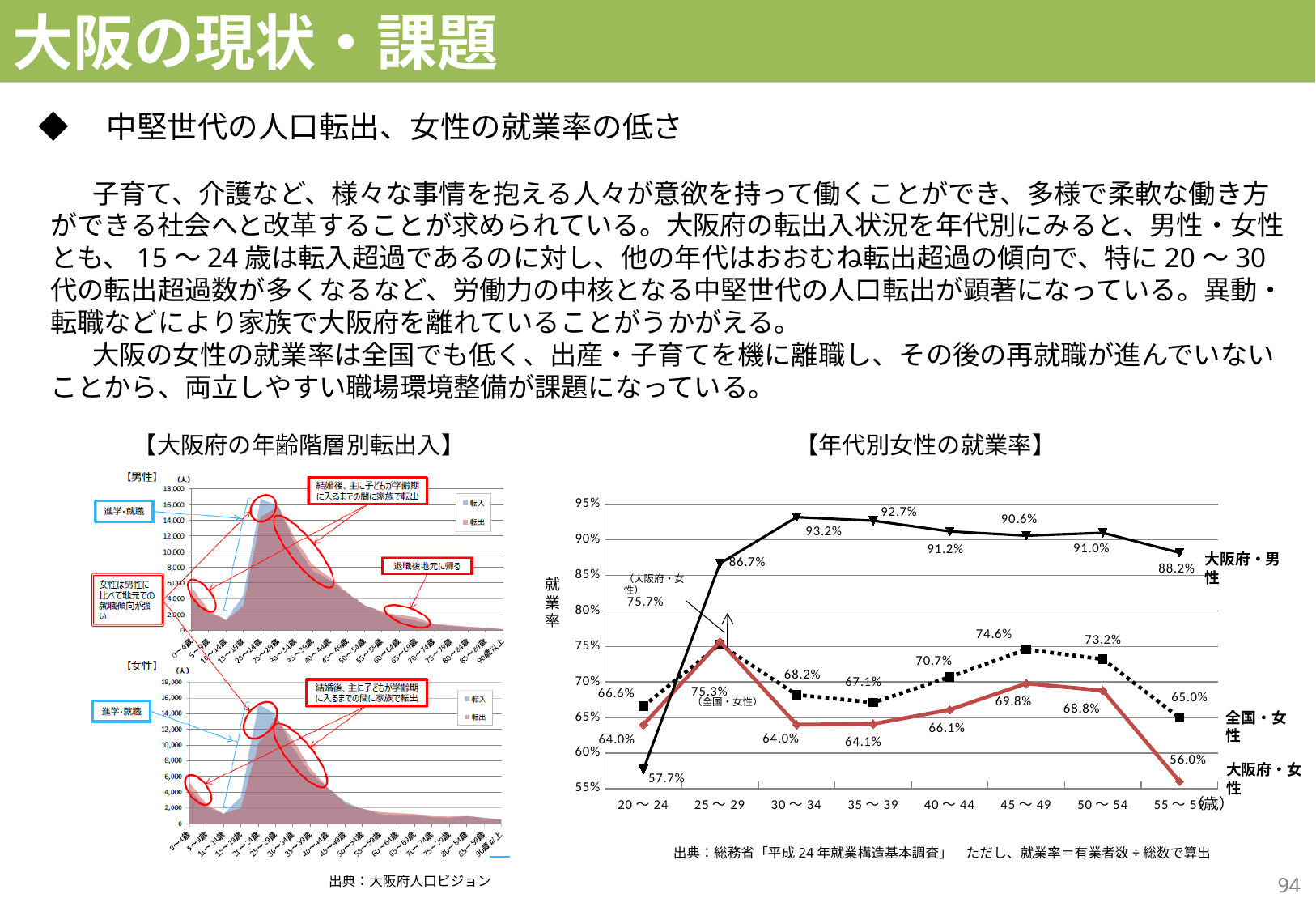
In the 【年代別女性の就業率】 chart, what is the value for 大阪府・女性 at 25～29? 75.7% In the 【大阪府の年齢階層別転出入】 charts, what two series does the legend list? 転入, 転出 In the 【年代別女性の就業率】 chart, which age group has the highest value for 大阪府・男性? 30～34 In the 【年代別女性の就業率】 chart, how many age groups are shown on the x axis? 8 In the 【年代別女性の就業率】 chart, what is the difference between 全国・女性 and 大阪府・女性 at 55～59? 9.0% In the 【年代別女性の就業率】 chart, what is the value for 全国・女性 at 45～49? 74.6% In the 【年代別女性の就業率】 chart, which age group has the lowest value for 大阪府・女性? 55～59 In the 【年代別女性の就業率】 chart, does the 大阪府・男性 series rise or fall from 20～24 to 30～34? rise In the 【年代別女性の就業率】 chart, which is larger at 25～29: 大阪府・女性 or 全国・女性? 大阪府・女性 What kind of chart is the 【年代別女性の就業率】 chart? line chart In the 【年代別女性の就業率】 chart, how many series are plotted? 3 In the 【年代別女性の就業率】 chart, what is the value for 大阪府・男性 at 20～24? 57.7%